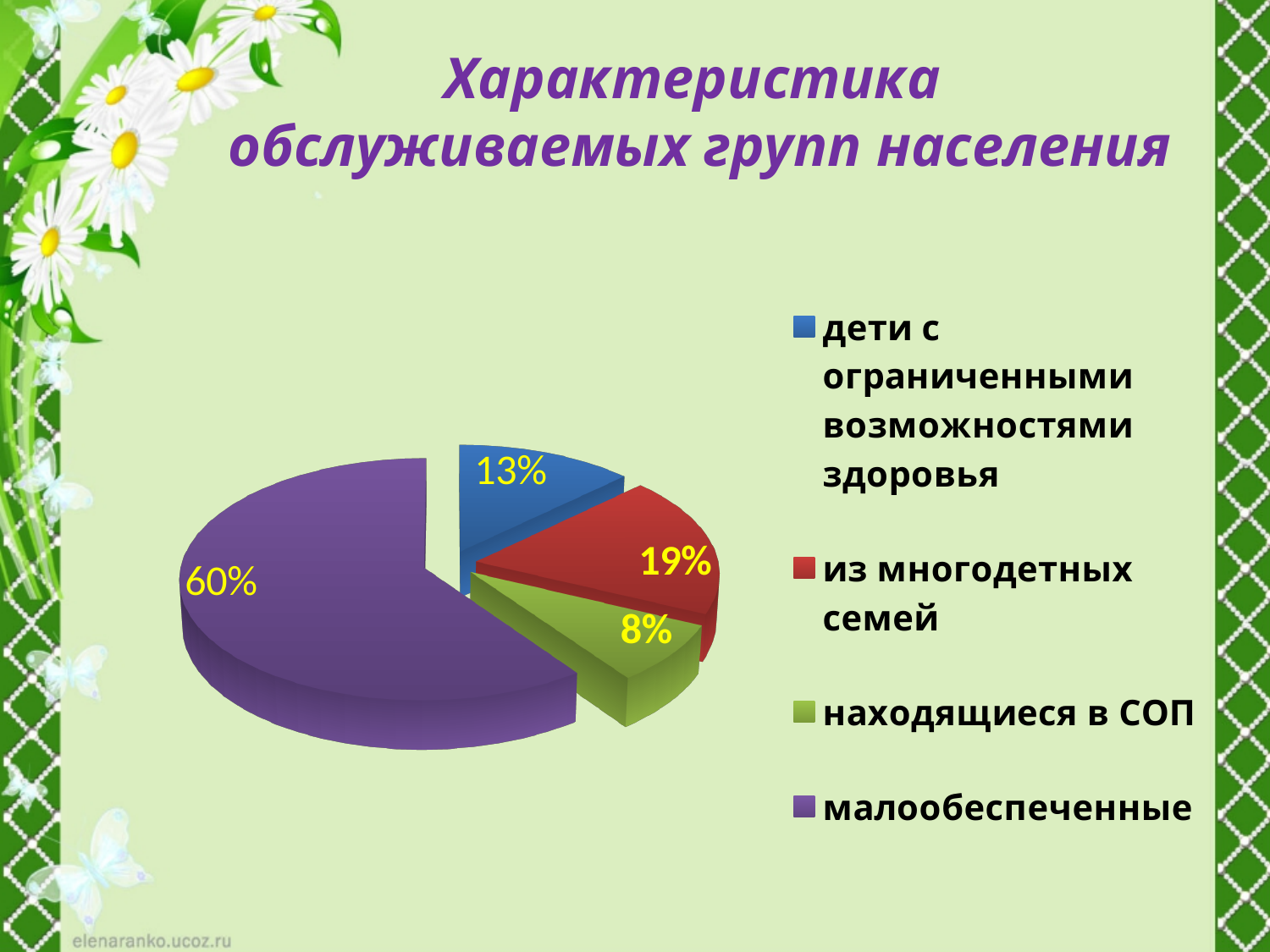
What is the title of the slide containing the chart? Характеристика обслуживаемых групп населения Which category has the smallest slice of the pie? находящиеся в СОП What kind of chart is shown on the slide? pie chart What share of the pie is labelled for "находящиеся в СОП"? 8% What share of the pie is labelled for "дети с ограниченными возможностями здоровья"? 13% What is the difference in percentage points between "малообеспеченные" and "из многодетных семей"? 41 What share of the pie is labelled for "малообеспеченные"? 60% Which is larger: the slice for "из многодетных семей" or the slice for "дети с ограниченными возможностями здоровья"? из многодетных семей Which category has the largest slice of the pie? малообеспеченные What share of the pie is labelled for "из многодетных семей"? 19% How many categories does the pie chart show? 4 What colour is the slice for "находящиеся в СОП"? green